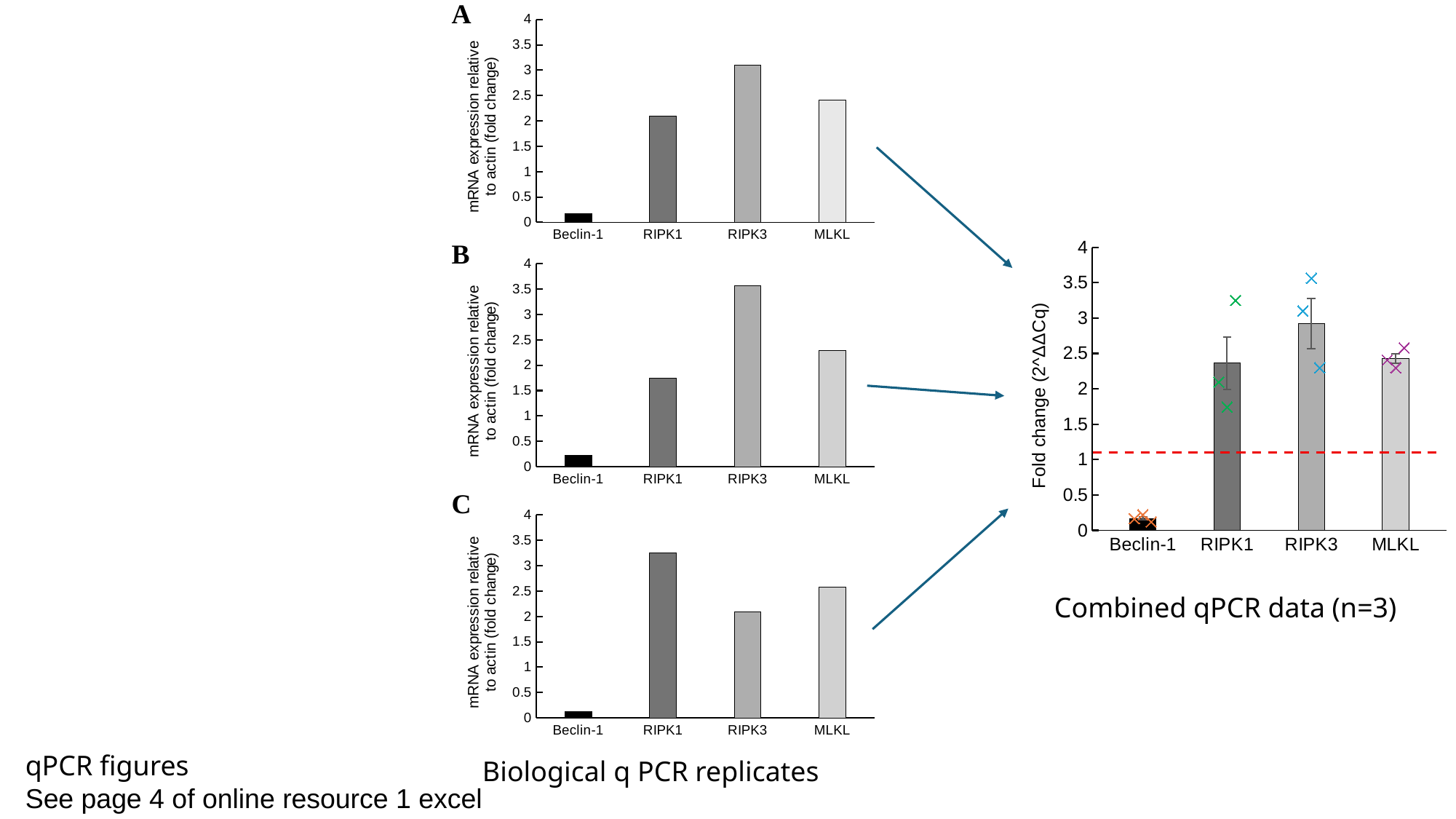
In chart B, which category has the highest bar? RIPK3 In the Combined qPCR data (n=3) chart, which category has the lowest bar? Beclin-1 In chart B, is the value for RIPK1 greater or less than 2? less What kind of chart is chart A? bar chart How many categories are shown on the x axis of the Combined qPCR data (n=3) chart? 4 In chart C, which is larger, the value for RIPK3 or the value for MLKL? MLKL In the Combined qPCR data (n=3) chart, is the value for Beclin-1 greater or less than 0.5? less In chart A, which category has the highest bar? RIPK3 In chart A, is the value for RIPK3 greater or less than 3? greater In chart C, which category has the highest bar? RIPK1